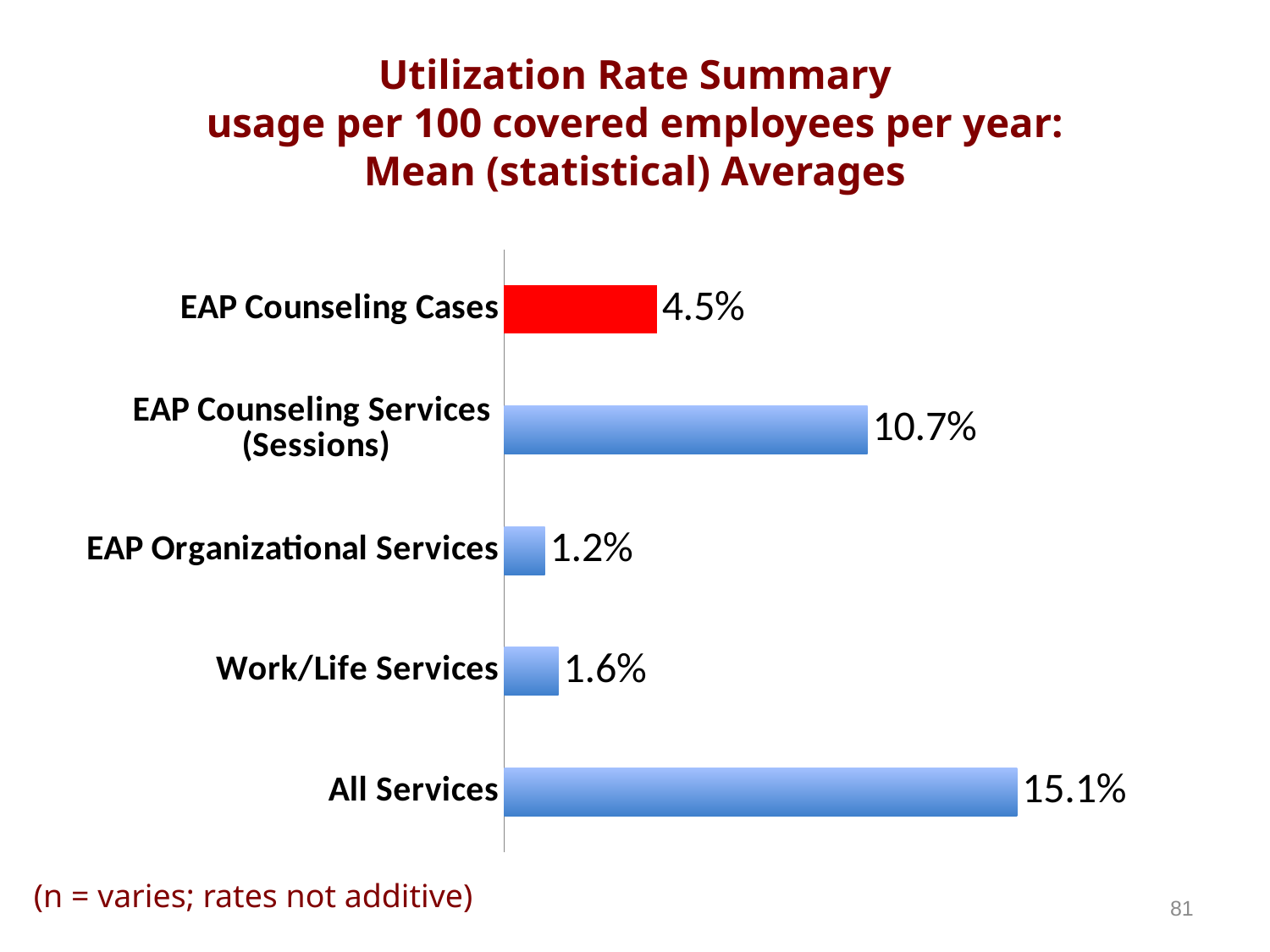
What kind of chart is shown on the slide? Bar chart What is the value for EAP Counseling Cases? 4.5% What is the value for EAP Organizational Services? 1.2% What is the value for EAP Counseling Services (Sessions)? 10.7% Which category has the lowest value? EAP Organizational Services What is the value for Work/Life Services? 1.6% What is the value for All Services? 15.1% Which category's bar is coloured red? EAP Counseling Cases Which category has the highest value? All Services Which is larger, the value for Work/Life Services or the value for EAP Organizational Services? Work/Life Services What is the difference between the values for All Services and EAP Counseling Services (Sessions)? 4.4% How many categories are shown in the chart? 5